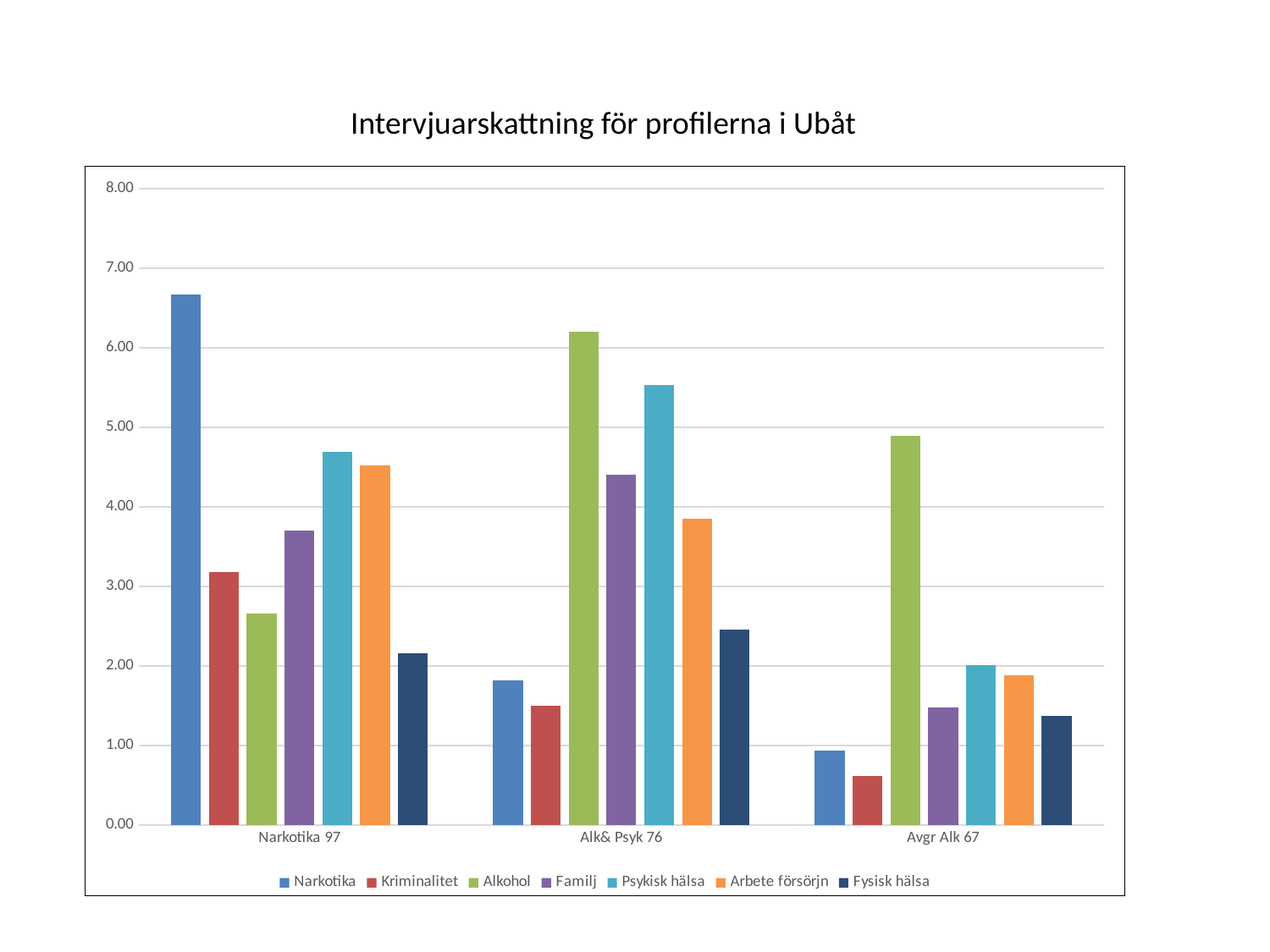
Within the Avgr Alk 67 category, which series has the lowest value? Kriminalitet Is the value for Narkotika in the Narkotika 97 category greater or less than 6.00? greater What is the title of the chart? Intervjuarskattning för profilerna i Ubåt How many categories are shown on the x axis? 3 Is the Familj value larger in the Narkotika 97 category or in the Alk& Psyk 76 category? Alk& Psyk 76 Is the value for Alkohol in the Avgr Alk 67 category greater or less than 4.00? greater Is the value for Kriminalitet in the Avgr Alk 67 category greater or less than 1.00? less How many series does the legend list? 7 In the Alk& Psyk 76 category, which is larger: Psykisk hälsa or Arbete försörjn? Psykisk hälsa Within the Narkotika 97 category, which series has the highest value? Narkotika Within the Alk& Psyk 76 category, which series has the highest value? Alkohol What kind of chart is shown on the slide? Bar chart